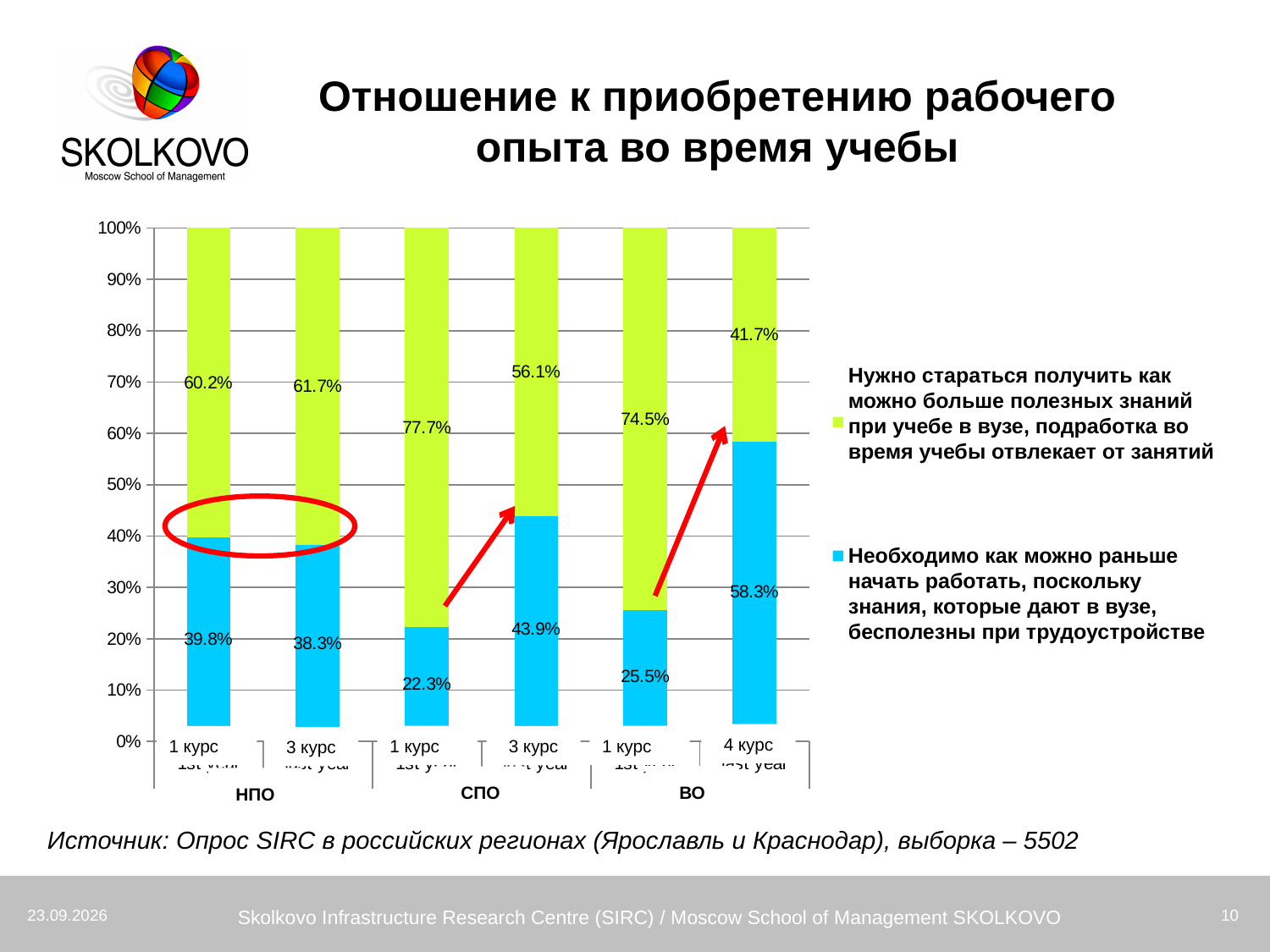
What is the difference between the blue-series values for 3 курс and 1 курс in the СПО group? 21.6% What is the green-series value for 3 курс in the НПО group? 61.7% Which colour represents the series 'Нужно стараться получить как можно больше полезных знаний при учебе в вузе'? green How many series does the legend list? 2 How many bars (groups of course/year) are plotted in the chart? 6 What type of chart is shown on the slide? stacked bar chart What is the green-series value (Нужно стараться получить как можно больше полезных знаний) for 1 курс in the СПО group? 77.7% Which bar has the lowest blue-series value (Необходимо как можно раньше начать работать)? 1 курс (СПО) Which bar has the highest blue-series value (Необходимо как можно раньше начать работать)? 4 курс (ВО) Which is larger: the green-series value for 1 курс in the ВО group or for 1 курс in the СПО group? 1 курс in the СПО group What is the blue-series value (Необходимо как можно раньше начать работать) for 1 курс in the НПО group? 39.8% What is the blue-series value for 4 курс in the ВО group? 58.3%